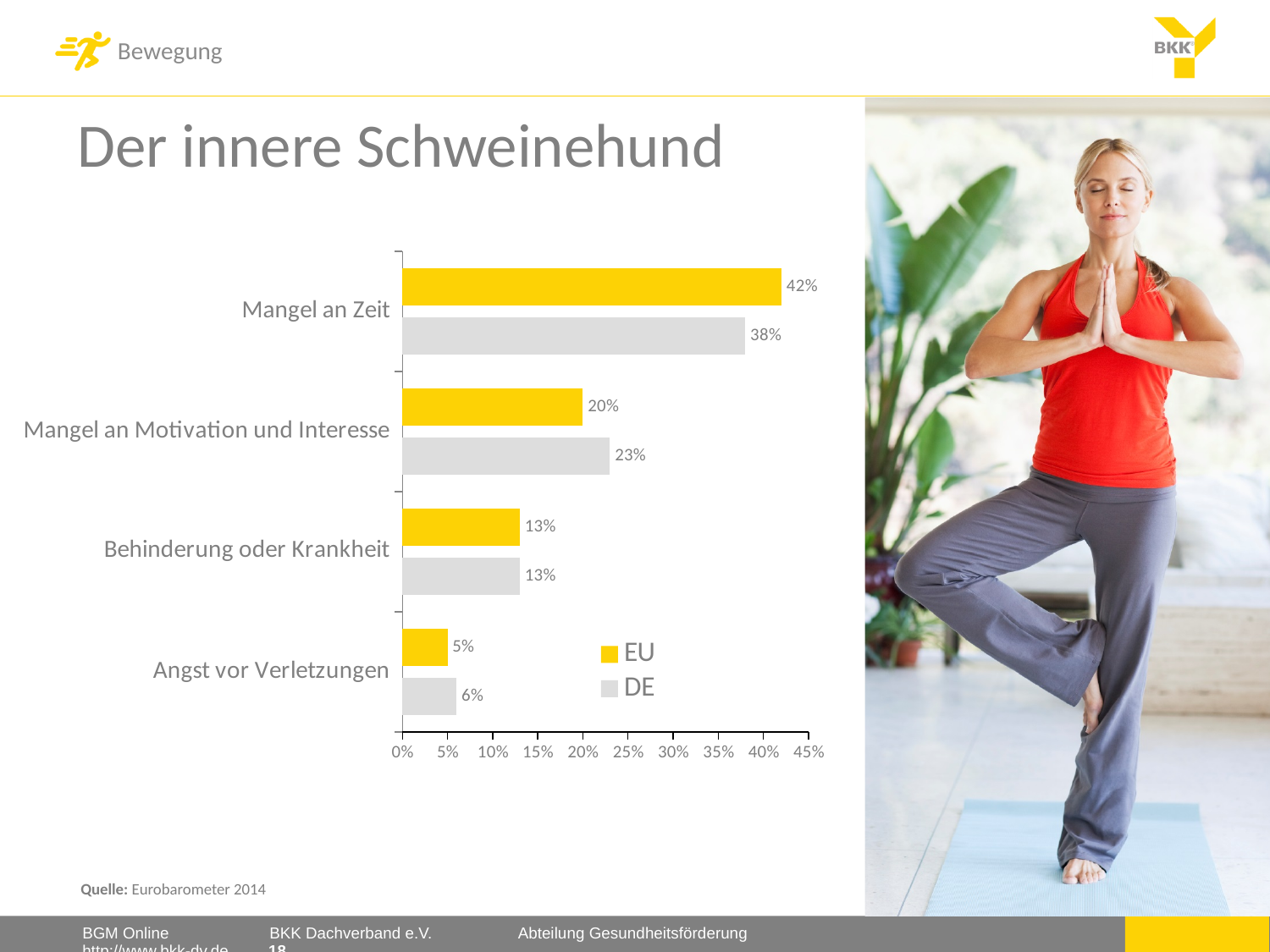
What is the difference between the EU and DE values for Mangel an Zeit? 4% What is the EU value for Mangel an Zeit? 42% What is the EU value for Behinderung oder Krankheit? 13% How many series does the legend list? 2 How many categories are shown on the chart? 4 Which category has the highest EU value? Mangel an Zeit For Mangel an Motivation und Interesse, which is larger, the EU value or the DE value? DE What kind of chart is shown on the slide? Bar chart Which colour represents the EU series in the chart? Yellow What is the DE value for Mangel an Motivation und Interesse? 23% Which category has the lowest DE value? Angst vor Verletzungen What is the DE value for Angst vor Verletzungen? 6%